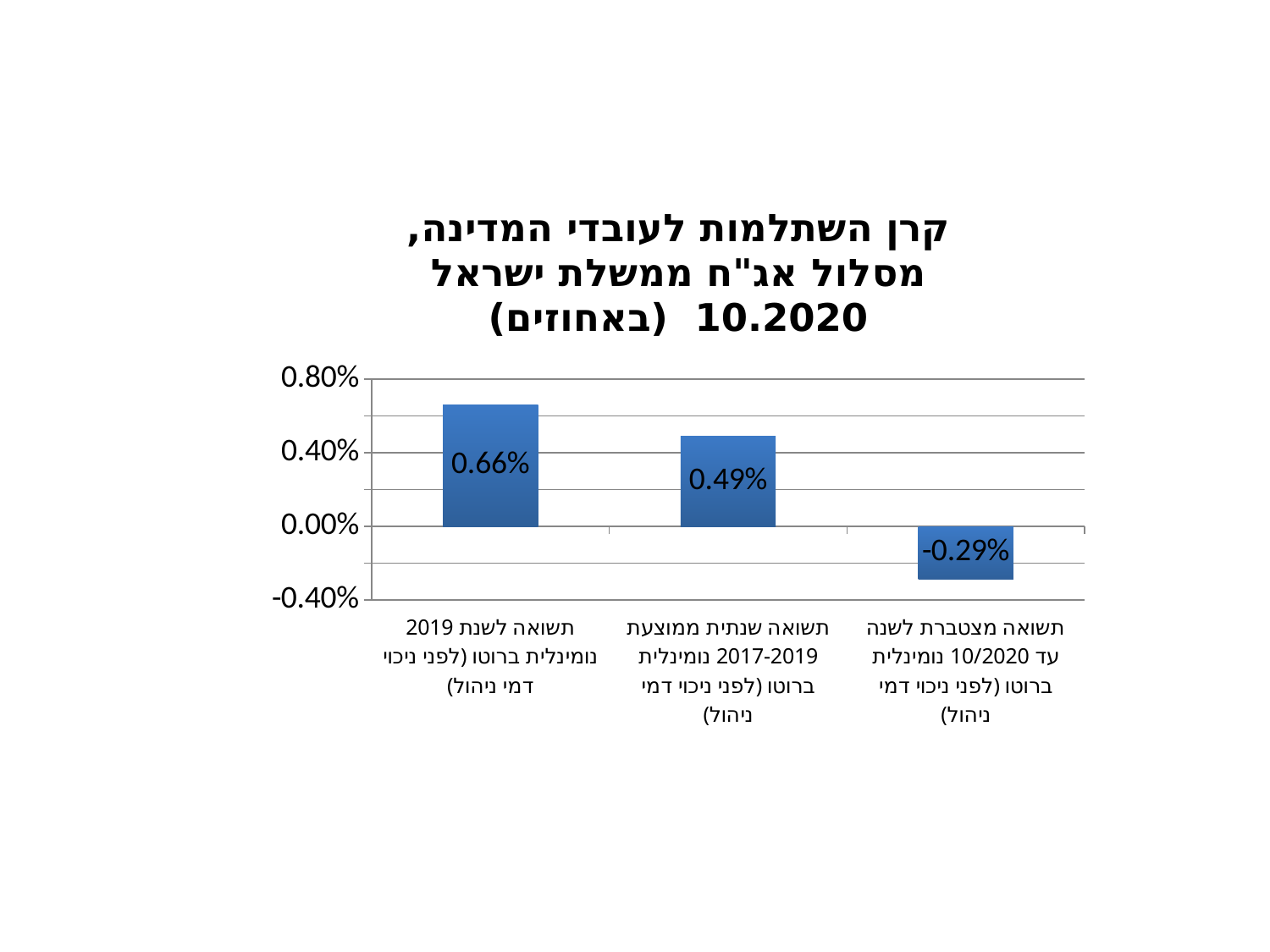
What is the difference between the 2019 return (0.66%) and the 2017-2019 average annual return (0.49%)? 0.17% What is the value for the average annual nominal gross return 2017-2019 (תשואה שנתית ממוצעת 2017-2019)? 0.49% Is the value for the 2017-2019 average annual return greater or less than 0.40%? greater What kind of chart is shown on the slide? Bar chart Which is larger: the 2019 nominal gross return or the cumulative return to 10/2020? The 2019 nominal gross return What is the value for the 2019 nominal gross return (תשואה לשנת 2019 נומינלית ברוטו)? 0.66% What is the value for the cumulative nominal gross return for the year to 10/2020 (תשואה מצטברת לשנה עד 10/2020)? -0.29% Do the values rise or fall from left to right across the categories? Fall How many categories are shown in the chart? 3 Which category has the highest value? תשואה לשנת 2019 נומינלית ברוטו (לפני ניכוי דמי ניהול) Which category has the lowest value? תשואה מצטברת לשנה עד 10/2020 נומינלית ברוטו (לפני ניכוי דמי ניהול) How many bars have a negative value? 1